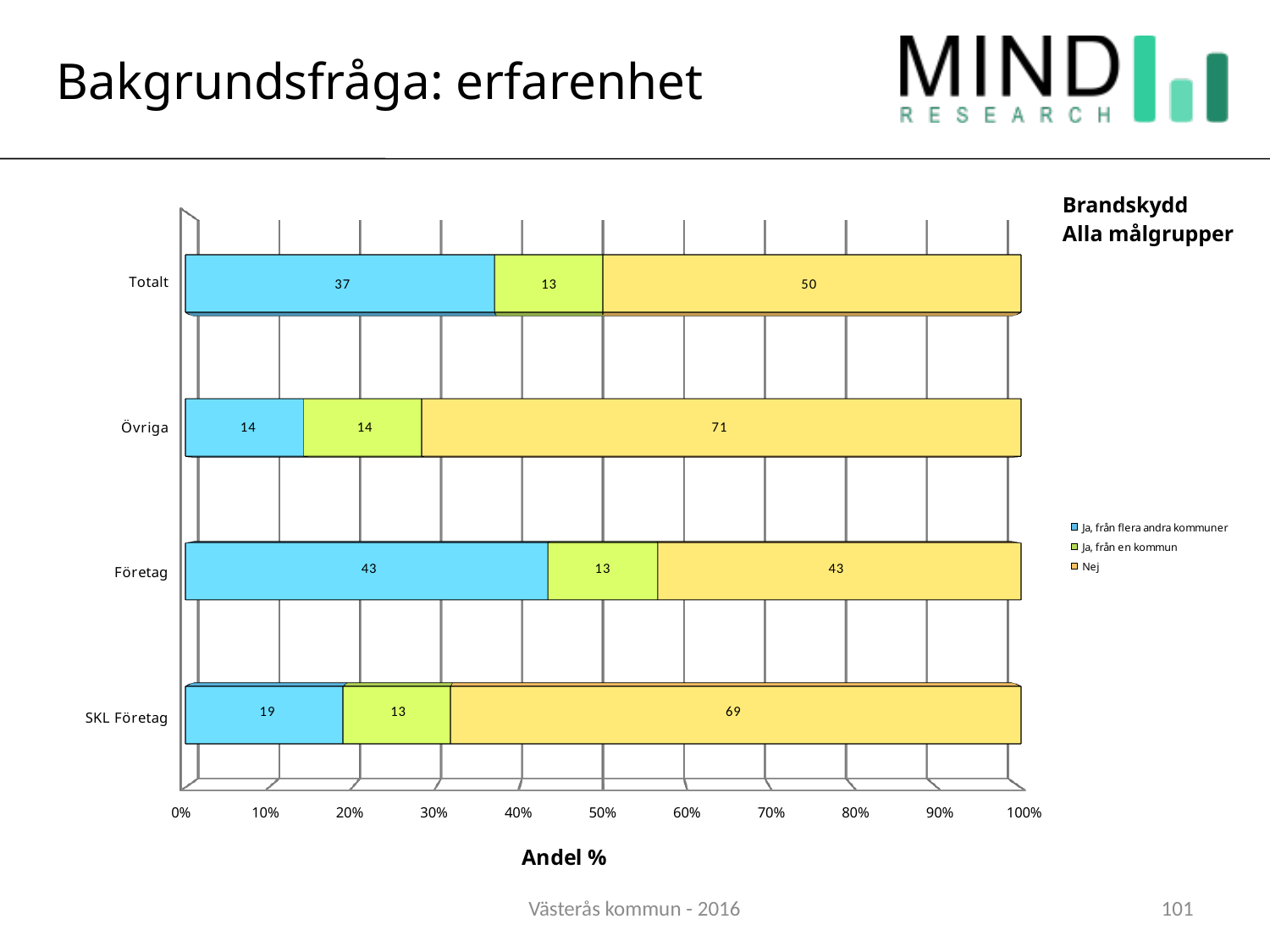
What is the value of 'Ja, från en kommun' for SKL Företag? 13 How many series does the chart legend list? 3 Which category has the lowest value for 'Ja, från flera andra kommuner'? Övriga How many categories are shown on the vertical axis of the chart? 4 What is the value of 'Nej' for Övriga? 71 What is the difference between the 'Nej' values for SKL Företag and Totalt? 19 Which category has the highest value for 'Nej'? Övriga What is the title of the horizontal axis of the chart? Andel % Which is larger: the 'Ja, från flera andra kommuner' value for Totalt or for SKL Företag? Totalt What kind of chart is shown on the slide? Stacked bar chart What is the value of 'Ja, från flera andra kommuner' for Företag? 43 What is the total of the stacked bar for Företag? 99